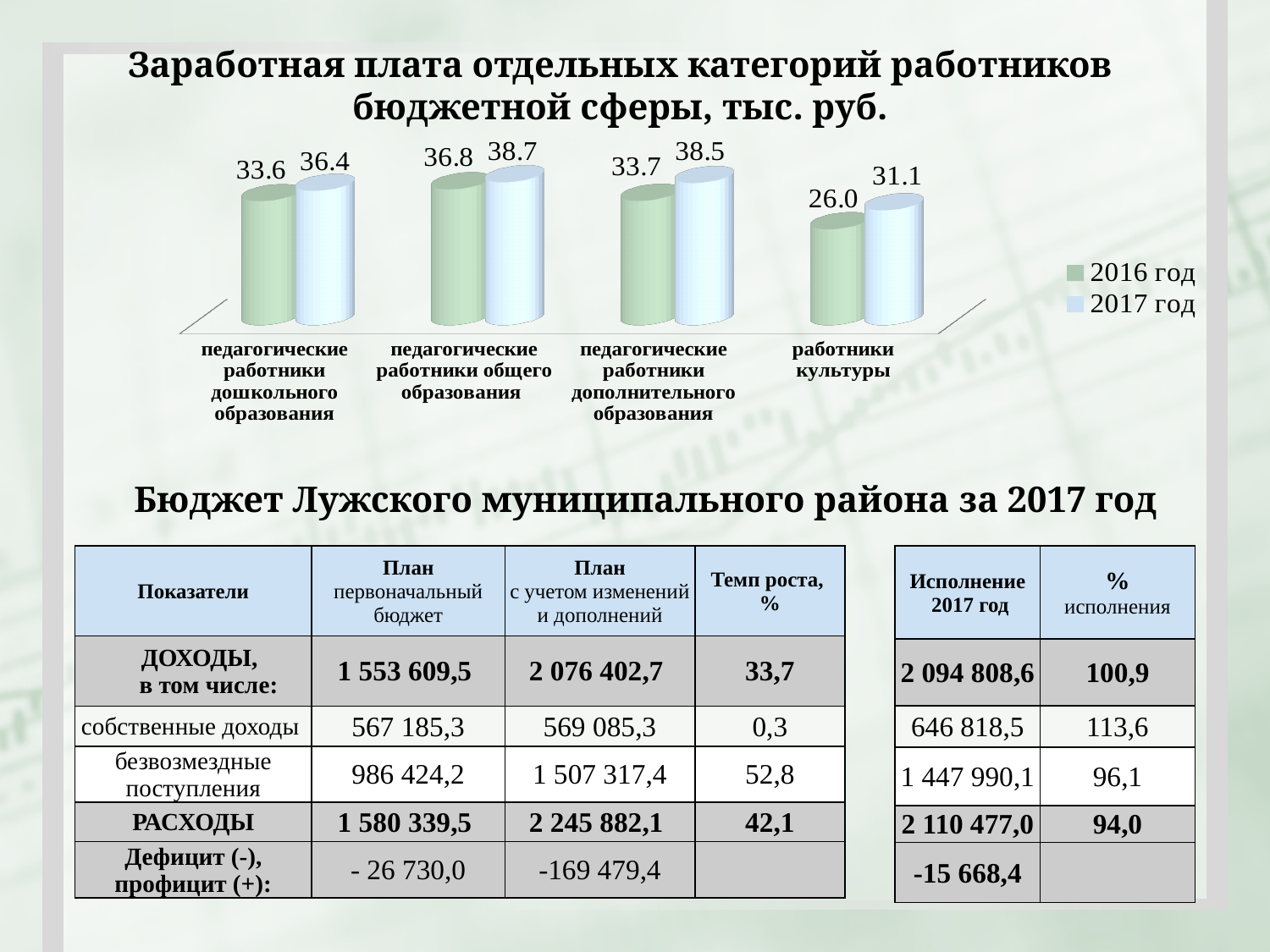
What is the 2016 value for работники культуры? 26.0 Which is larger: the 2016 value for педагогические работники общего образования or the 2016 value for педагогические работники дошкольного образования? педагогические работники общего образования What is the difference between the 2017 and 2016 values for педагогические работники дополнительного образования? 4.8 What is the 2017 value for педагогические работники дошкольного образования? 36.4 Which category has the lowest 2016 value? работники культуры What are the two series named in the chart legend? 2016 год and 2017 год What is the 2017 value for педагогические работники общего образования? 38.7 Which category has the highest 2017 value? педагогические работники общего образования How many series does the chart legend list? 2 What is the difference between the 2017 and 2016 values for работники культуры? 5.1 How many categories are shown on the chart? 4 What kind of chart is shown on the slide? bar chart